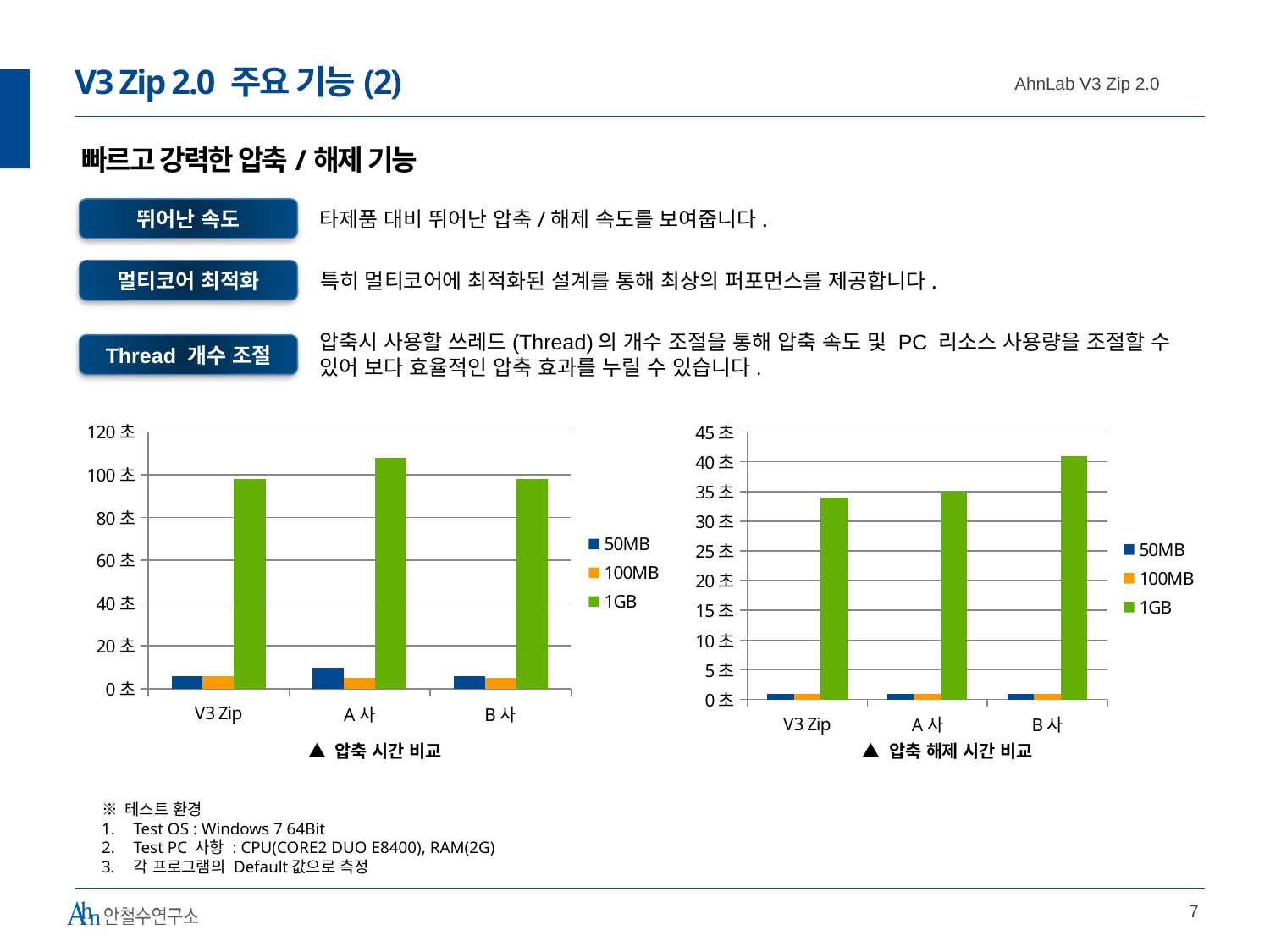
What kind of chart is the '압축 시간 비교' chart on the left? bar chart In the '압축 시간 비교' chart, which is larger, the 1GB value for V3 Zip or for A 사? A 사 In the '압축 시간 비교' chart, is the 50MB value for A 사 greater or less than 20 초? less How many categories are shown on the x axis of the '압축 시간 비교' chart? 3 What colour are the 1GB bars in the '압축 시간 비교' chart? green In the '압축 시간 비교' chart, which category has the highest 1GB bar? A 사 In the '압축 해제 시간 비교' chart, which category has the highest 1GB bar? B 사 In the '압축 시간 비교' chart, is the 1GB value for A 사 greater or less than 100 초? greater How many series does the legend of the '압축 해제 시간 비교' chart list? 3 In the '압축 해제 시간 비교' chart, which is larger, the 1GB value for V3 Zip or for B 사? B 사